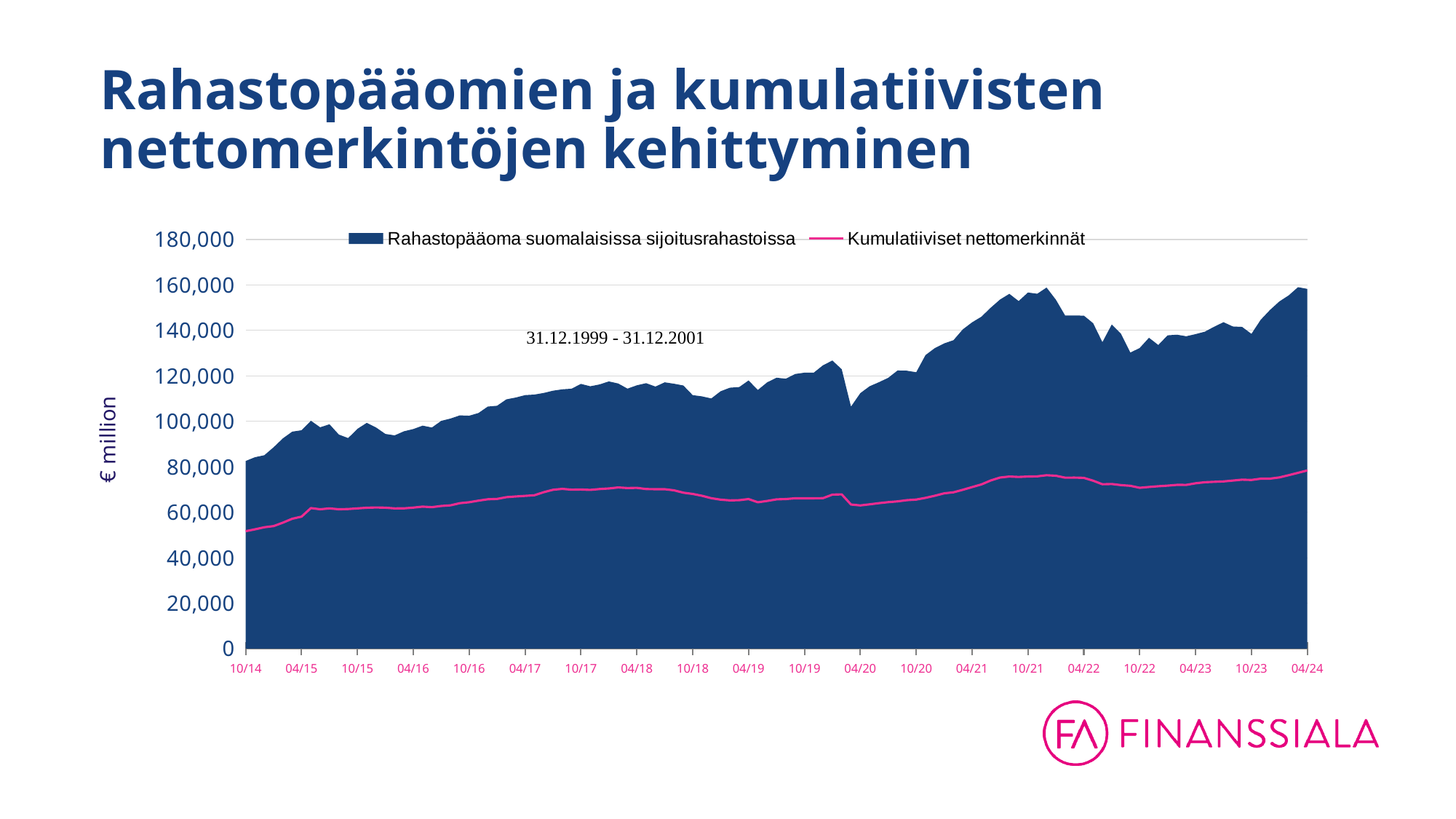
Is the value of Rahastopääoma suomalaisissa sijoitusrahastoissa at 10/21 greater or less than 140,000? greater Is the value of Kumulatiiviset nettomerkinnät at 04/24 greater or less than 100,000? less What is the unit shown on the y-axis label? € million Is the value of Rahastopääoma suomalaisissa sijoitusrahastoissa at 10/14 greater or less than 100,000? less What kind of chart is shown on the slide? An area chart with a line series At which x-axis label is Kumulatiiviset nettomerkinnät at its lowest? 10/14 Which series is drawn as a pink line? Kumulatiiviset nettomerkinnät At 04/24, which series has the larger value: Rahastopääoma suomalaisissa sijoitusrahastoissa or Kumulatiiviset nettomerkinnät? Rahastopääoma suomalaisissa sijoitusrahastoissa Does Rahastopääoma suomalaisissa sijoitusrahastoissa overall rise or fall from 10/14 to 04/24? Rise How many series does the legend list? 2